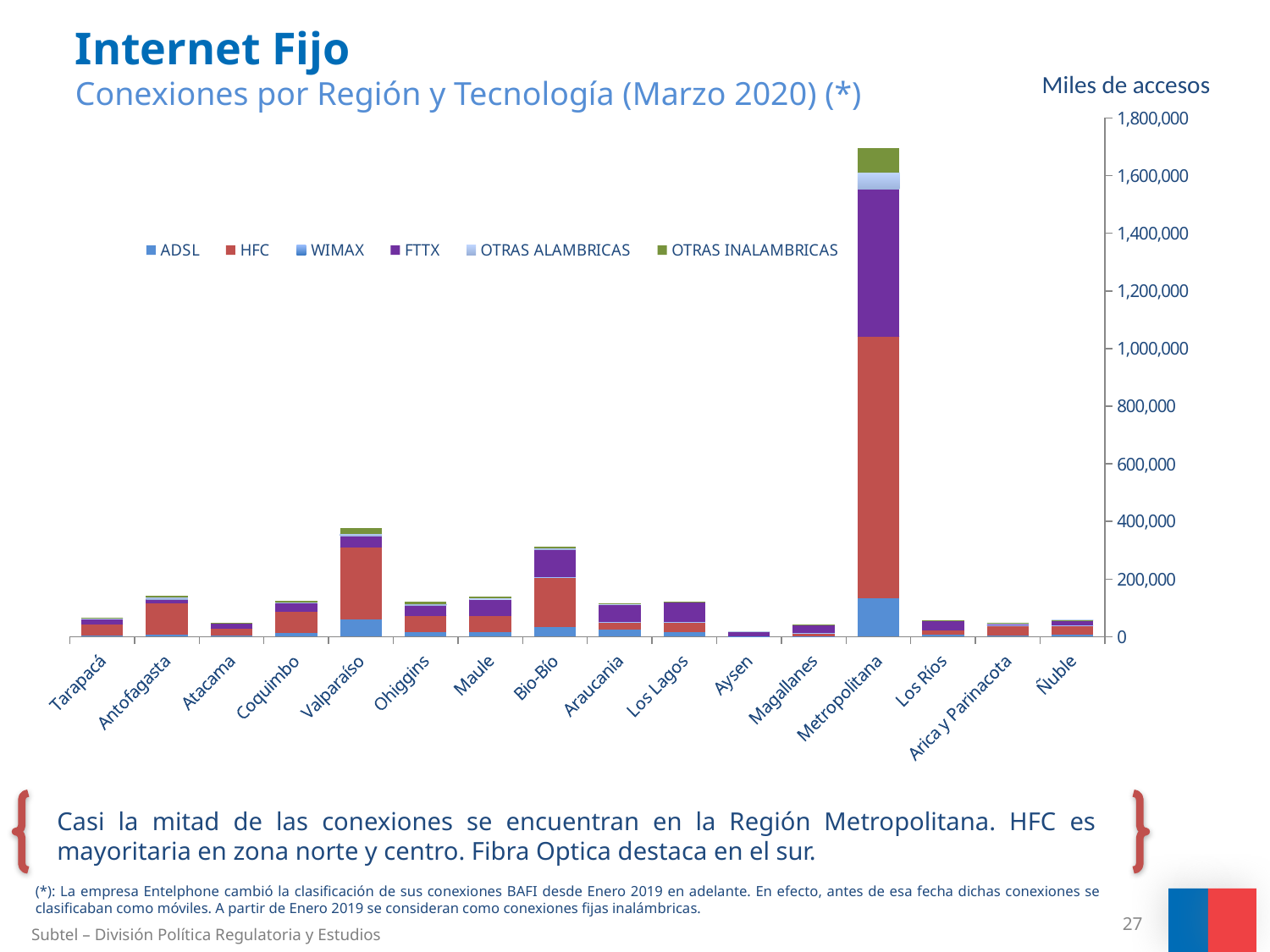
How many series does the chart legend list? 6 Which region has the highest total number of connections? Metropolitana Is the total for Aysen greater or less than 200,000? less Which region has a larger total, Valparaíso or Bio-Bío? Valparaíso Is the total for Metropolitana greater or less than 1,600,000? greater What kind of chart is shown on the slide? Stacked bar chart What unit label is shown above the vertical axis? Miles de accesos Which region has the lowest total number of connections? Aysen Which technology forms the largest segment of the Metropolitana bar? HFC How many regions are shown along the x axis of the chart? 16 Which series is shown in green in the legend? OTRAS INALAMBRICAS Is the total for Valparaíso greater or less than 200,000? greater